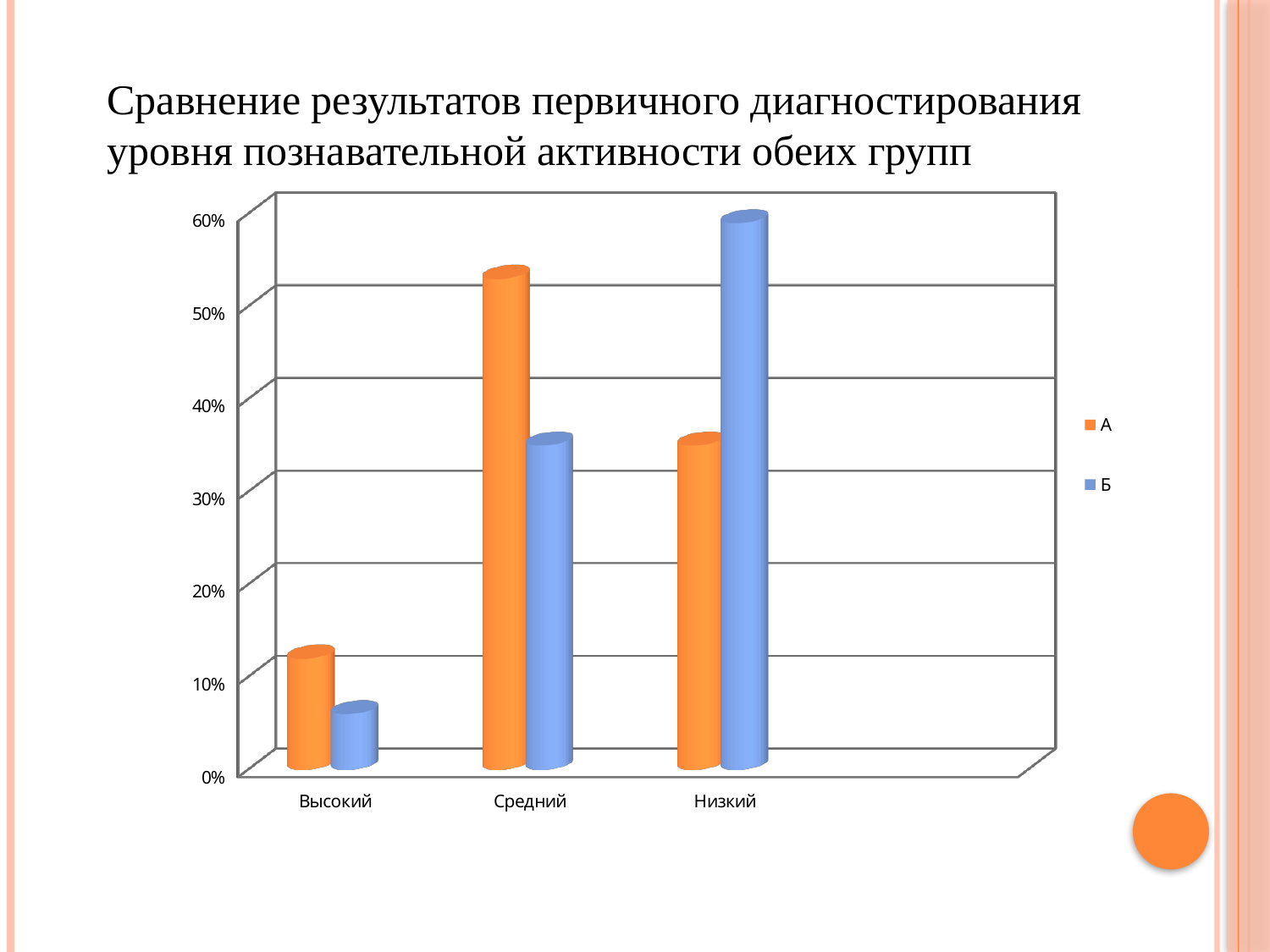
Which category has the lowest value for series Б? Высокий Is the value for series Б in the Средний category greater or less than 40%? less Which category has the highest value for series А? Средний What colour are the bars for series А? orange Is the value for series А in the Средний category greater or less than 50%? greater Is the value for series Б in the Высокий category greater or less than 20%? less In the Низкий category, which series has the larger value, А or Б? Б How many series does the chart's legend list? 2 In the Средний category, which series has the larger value, А or Б? А Which category has the highest value for series Б? Низкий What kind of chart is shown on the slide? bar chart How many categories are shown on the x axis of the chart? 3